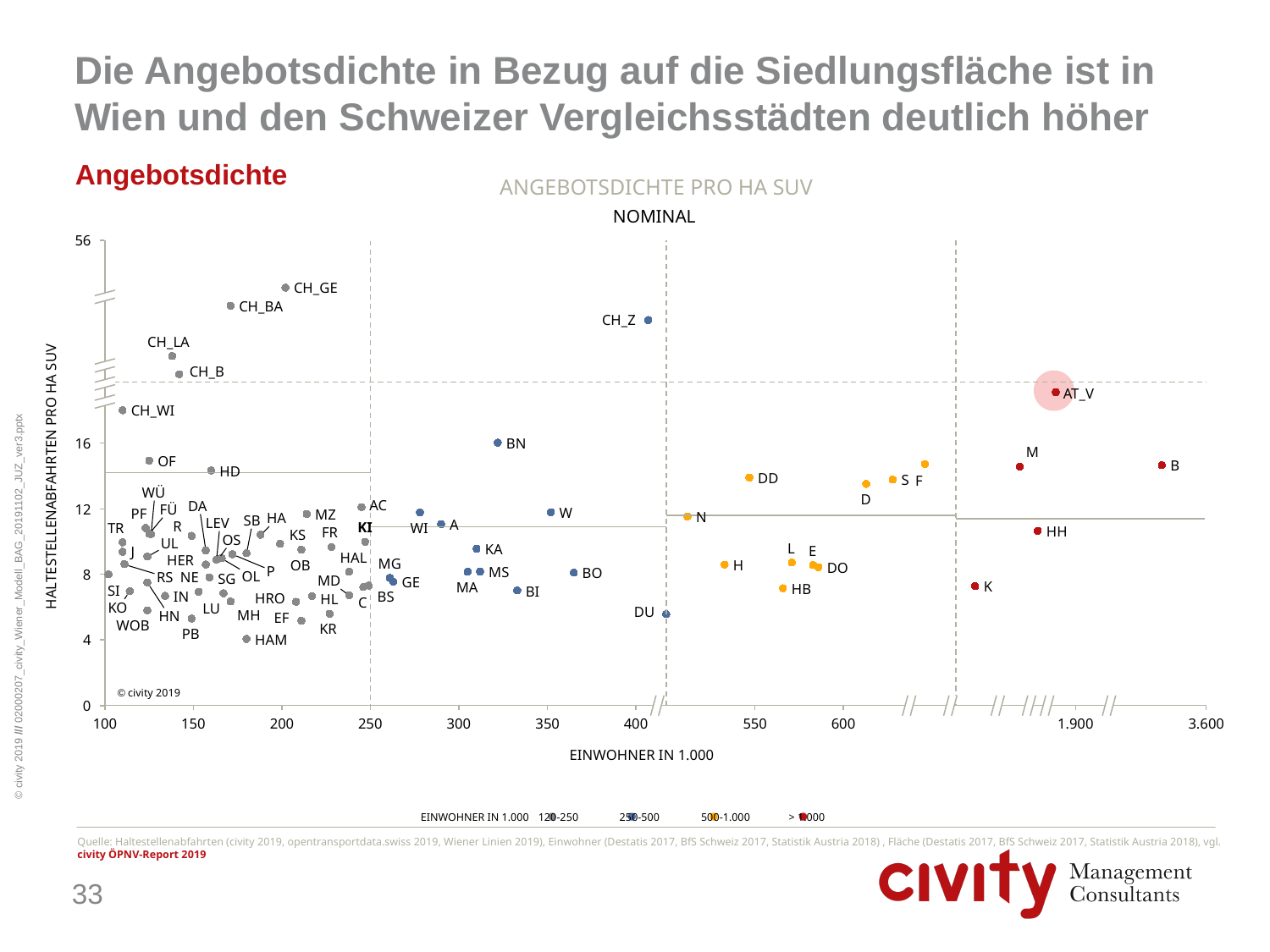
Which has the higher value on the vertical axis, AT_V or B? AT_V What kind of chart is shown on the slide? scatter plot Is the value for DU on the vertical axis greater or less than 8? less Which has the higher value on the vertical axis, CH_GE or CH_BA? CH_GE Is the value for AT_V on the vertical axis greater or less than 16? greater Which city has the highest value on the vertical axis (Haltestellenabfahrten pro ha SUV)? CH_GE What is the label of the horizontal axis? EINWOHNER IN 1.000 Which city has the lowest value on the vertical axis? HAM What is the title printed above the chart? ANGEBOTSDICHTE PRO HA SUV How many population groups does the legend list? 4 Is the value for HH on the vertical axis greater or less than 12? less